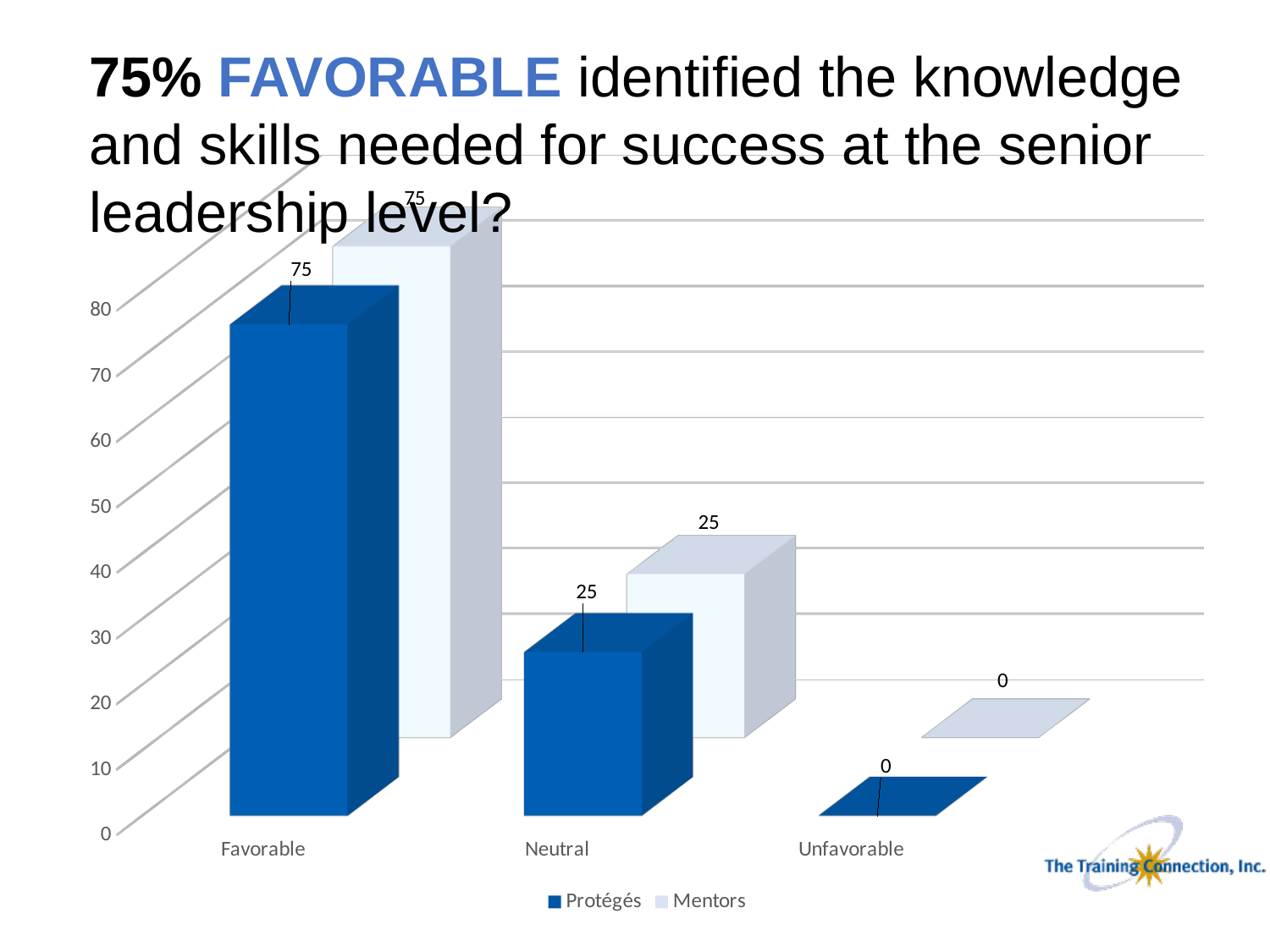
What is the difference between the Protégés values for Favorable and Neutral? 50 Which category has the lowest value for Mentors? Unfavorable What is the value for Mentors in the Favorable category? 75 How many categories are shown on the x axis? 3 Which is larger for Mentors: Favorable or Neutral? Favorable What is the value for Mentors in the Neutral category? 25 What is the value for Protégés in the Favorable category? 75 Which category has the highest value for Protégés? Favorable Do the Protégés values rise or fall from Favorable to Unfavorable? Fall How many series does the legend list? 2 What kind of chart is shown on the slide? Bar chart What is the value for Protégés in the Unfavorable category? 0